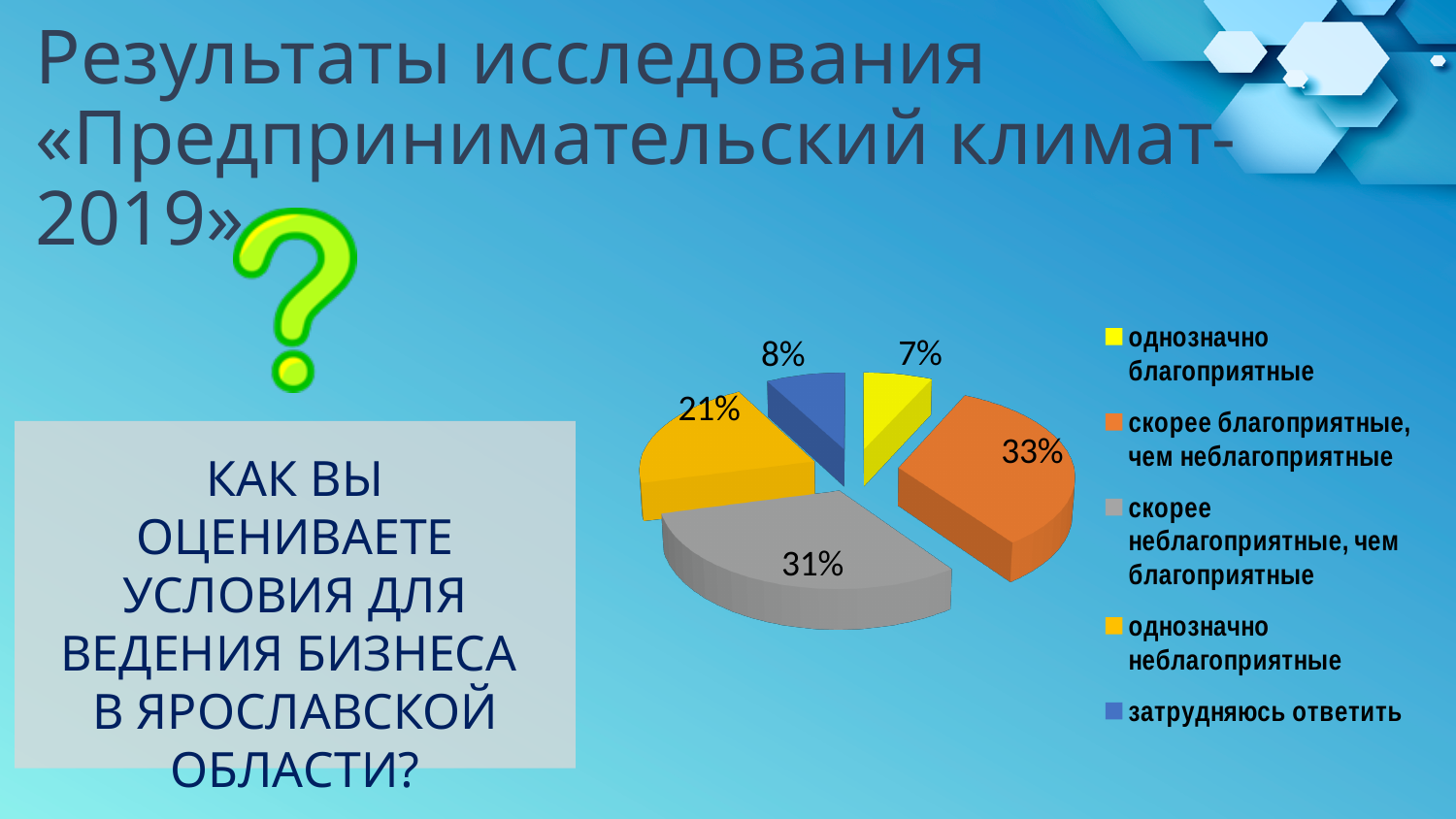
Which is larger: the share for «однозначно неблагоприятные» or the share for «затрудняюсь ответить»? однозначно неблагоприятные What share of respondents answered «однозначно благоприятные»? 7% What share of respondents answered «однозначно неблагоприятные»? 21% What share of respondents answered «затрудняюсь ответить»? 8% What is the difference between the shares for «скорее неблагоприятные, чем благоприятные» and «однозначно неблагоприятные»? 10% What kind of chart is shown on the slide? pie chart What colour is the slice for «затрудняюсь ответить»? blue How many answer options (slices) does the pie chart show? 5 What share of respondents answered «скорее неблагоприятные, чем благоприятные»? 31% What share of respondents answered «скорее благоприятные, чем неблагоприятные»? 33% Which answer option has the smallest share in the pie chart? однозначно благоприятные Which answer option has the largest share in the pie chart? скорее благоприятные, чем неблагоприятные